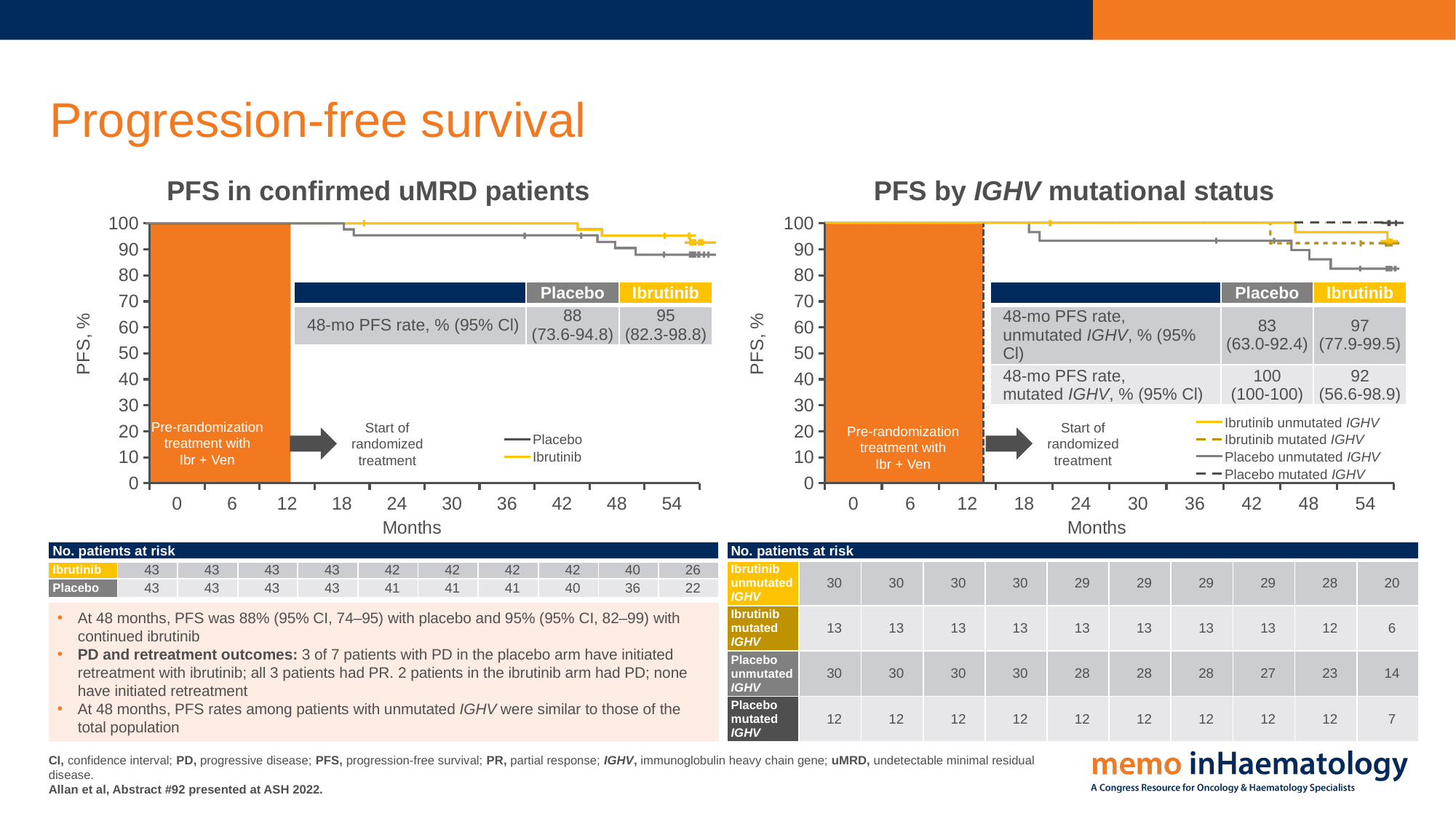
In the chart titled 'PFS by IGHV mutational status', what is the 48-month PFS rate for placebo in patients with mutated IGHV? 100 In the chart titled 'PFS in confirmed uMRD patients', what is the 48-month PFS rate for placebo? 88 In the chart titled 'PFS in confirmed uMRD patients', what is the difference between the ibrutinib and placebo 48-month PFS rates? 7 In the chart titled 'PFS by IGHV mutational status', what is the 48-month PFS rate for ibrutinib in patients with unmutated IGHV? 97 In the chart titled 'PFS in confirmed uMRD patients', what is the 48-month PFS rate for ibrutinib? 95 What kind of chart is the chart titled 'PFS by IGHV mutational status'? Line chart In the chart titled 'PFS in confirmed uMRD patients', which arm has the higher 48-month PFS rate, placebo or ibrutinib? Ibrutinib In the chart titled 'PFS in confirmed uMRD patients', how many series does the legend list? 2 In the chart titled 'PFS by IGHV mutational status', what is the difference between the ibrutinib and placebo 48-month PFS rates in unmutated IGHV patients? 14 In the chart titled 'PFS in confirmed uMRD patients', what is the 95% CI shown for the ibrutinib 48-month PFS rate? 82.3-98.8 In the chart titled 'PFS by IGHV mutational status', how many series does the legend list? 4 In the chart titled 'PFS in confirmed uMRD patients', is the placebo curve at 54 months greater or less than 90? less